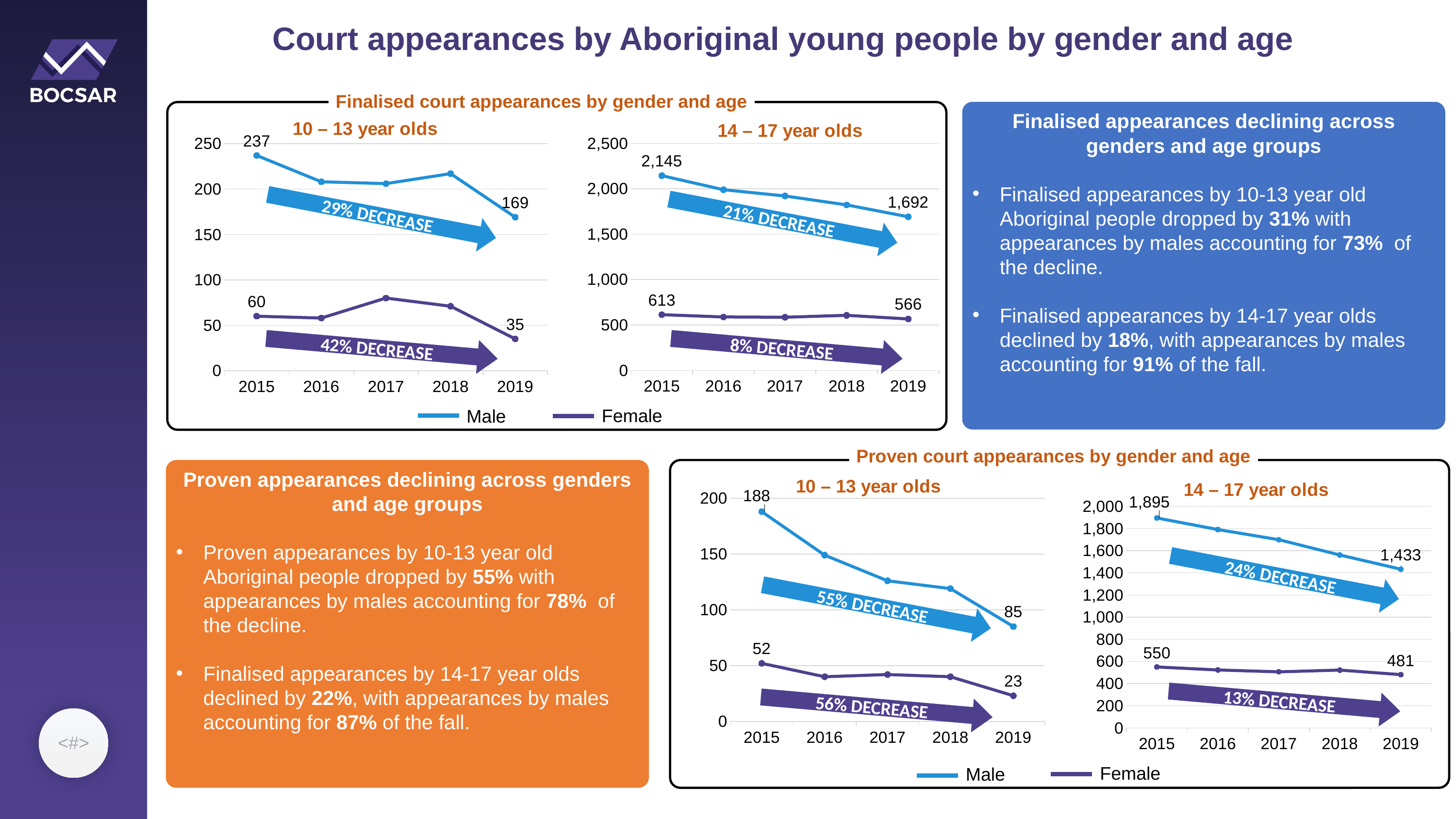
In the 'Proven court appearances' chart for 10 – 13 year olds, what was the Male value in 2019? 85 In the 'Proven court appearances' chart for 10 – 13 year olds, is the Male value in 2017 greater or less than 150? less In the 'Proven court appearances' chart for 14 – 17 year olds, what was the Female value in 2019? 481 What kind of chart is used in the 'Proven court appearances' chart for 10 – 13 year olds? Line chart In the 'Finalised court appearances' chart for 10 – 13 year olds, what was the Female value in 2019? 35 In the 'Proven court appearances' chart for 14 – 17 year olds, by how much did the Male value fall from 2015 to 2019? 462 In the 'Finalised court appearances' chart for 10 – 13 year olds, by how much did the Female value fall from 2015 to 2019? 25 How many series does the legend list for the 'Finalised court appearances by gender and age' charts? 2 In the 'Finalised court appearances' chart for 14 – 17 year olds, what was the Male value in 2019? 1,692 In the 'Finalised court appearances' chart for 14 – 17 year olds, which series is higher in 2019, Male or Female? Male In the 'Finalised court appearances' chart for 10 – 13 year olds, what was the Male value in 2015? 237 In the 'Finalised court appearances' chart for 14 – 17 year olds, what was the Female value in 2015? 613